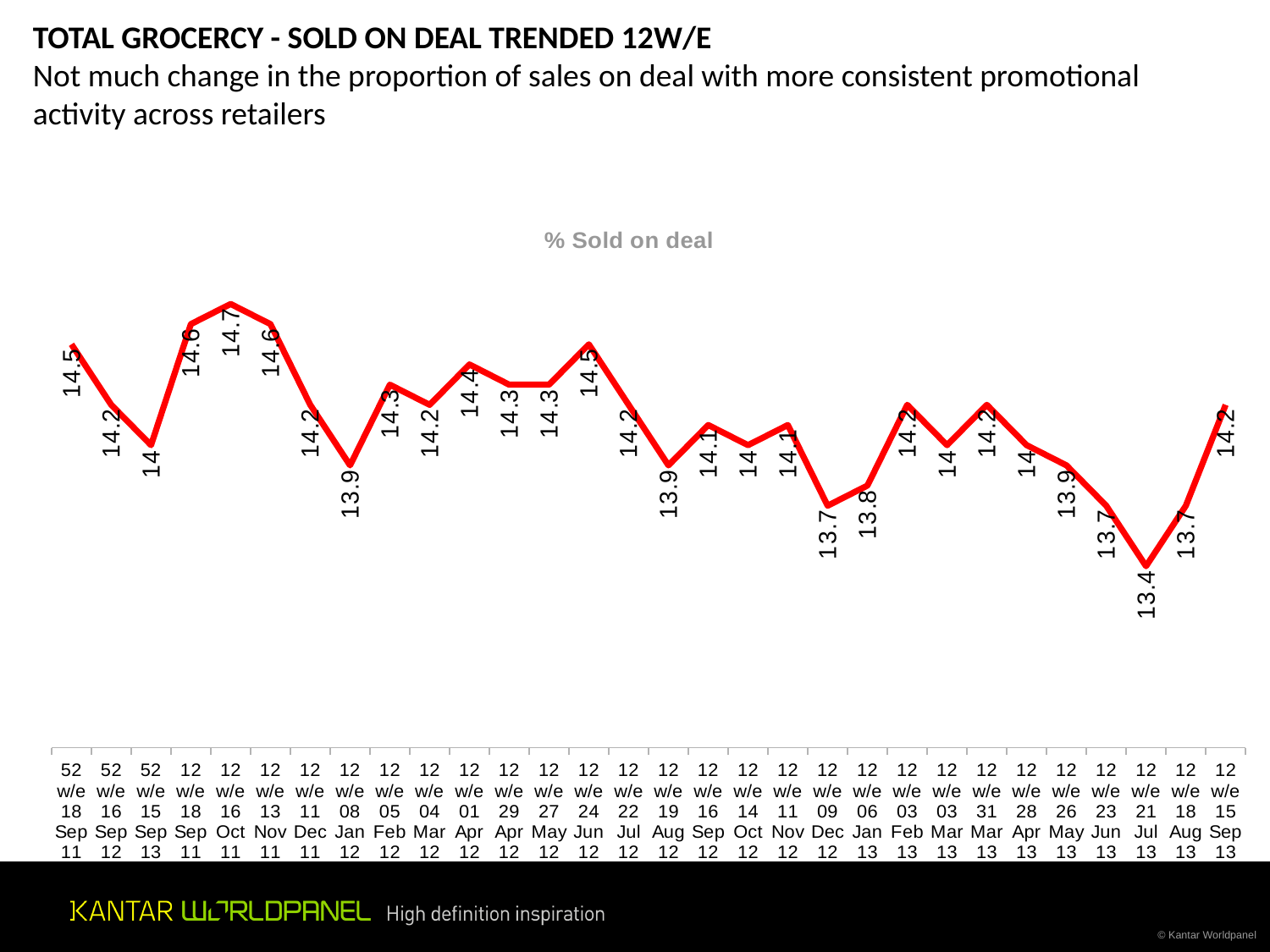
What type of chart is shown on the slide? line chart What is the title of the chart? % Sold on deal What is the difference between the value for 12 w/e 16 Oct 11 and the value for 12 w/e 21 Jul 13? 1.3 What is the value for 12 w/e 16 Oct 11? 14.7 Which period has the lowest % sold on deal? 12 w/e 21 Jul 13 How many data points are plotted on the chart? 30 What is the value for 12 w/e 15 Sep 13? 14.2 What is the value for 52 w/e 18 Sep 11? 14.5 What is the difference between the value for 12 w/e 18 Aug 13 and the value for 12 w/e 15 Sep 13? 0.5 Which is larger, the value for 12 w/e 24 Jun 12 or the value for 12 w/e 09 Dec 12? 12 w/e 24 Jun 12 What is the value for 12 w/e 21 Jul 13? 13.4 Which period has the highest % sold on deal? 12 w/e 16 Oct 11